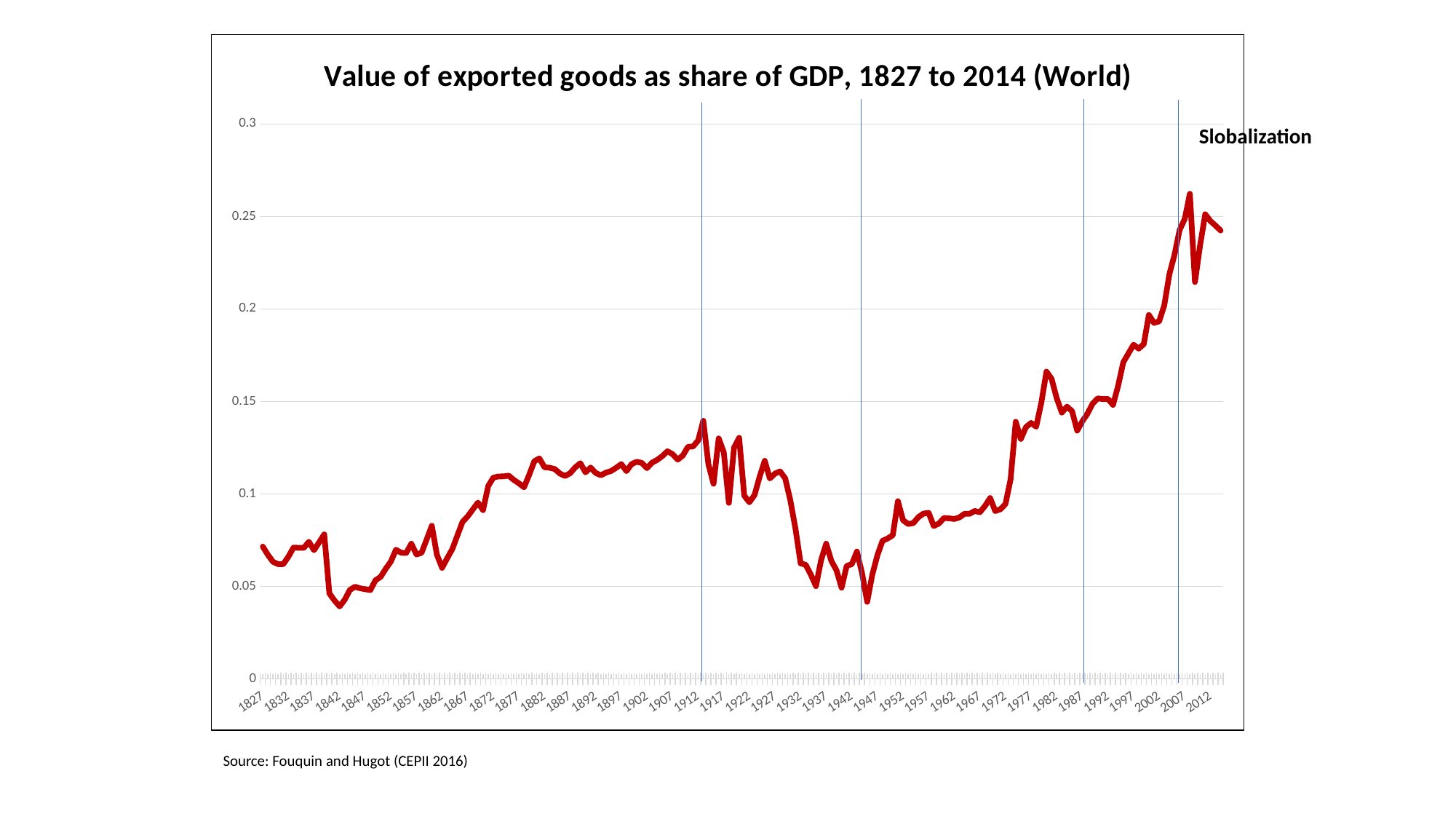
Is the value for 1842 greater or less than 0.05? less What kind of chart is shown on the slide? Line chart How many data series are plotted on the chart? 1 What is the title of the chart? Value of exported goods as share of GDP, 1827 to 2014 (World) Is the value for 1932 greater or less than 0.1? less Is the value for 1827 greater or less than 0.05? greater Does the value of exported goods as a share of GDP generally rise or fall between 1947 and 2007? Rise Does the value of exported goods as a share of GDP generally rise or fall between 1912 and 1947? Fall What annotation text appears at the top right of the chart? Slobalization